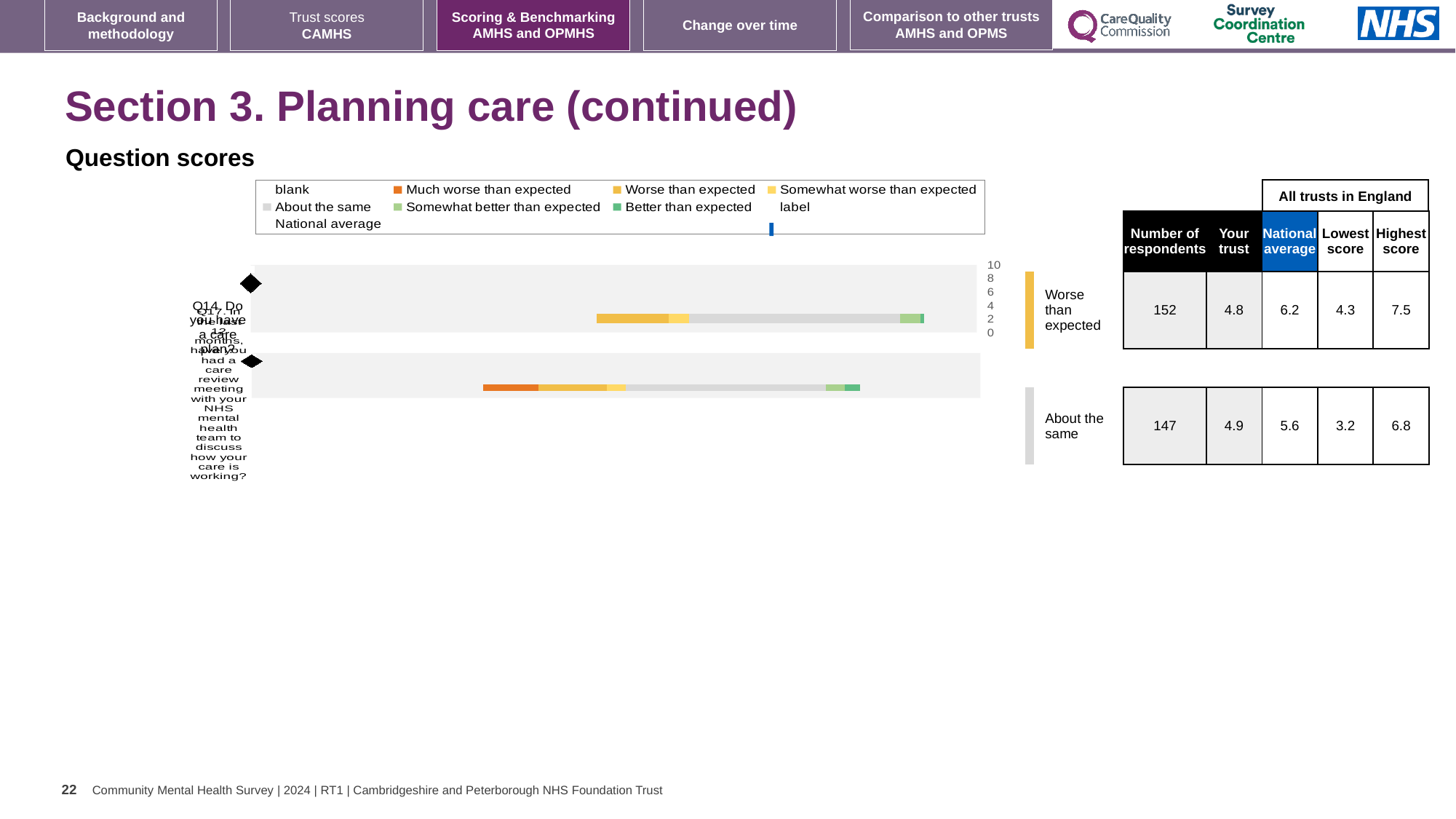
What is the national average for the row rated 'Worse than expected'? 6.2 For the row rated 'Worse than expected', how much higher is the national average than the 'Your trust' score? 1.4 How many question bars are plotted in the chart? 2 Which row has more respondents, 'Worse than expected' or 'About the same'? Worse than expected Which colour in the legend represents 'Much worse than expected'? orange What is the highest score among all trusts in England for the row rated 'About the same'? 6.8 In the table beside the chart, what is the 'Your trust' score for the row rated 'About the same'? 4.9 In the table beside the chart, what is the number of respondents for the row rated 'Worse than expected'? 152 What kind of chart is shown under 'Question scores'? bar chart What is the lowest score among all trusts in England for the row rated 'Worse than expected'? 4.3 For the row rated 'About the same', what is the difference between the highest score and the lowest score? 3.6